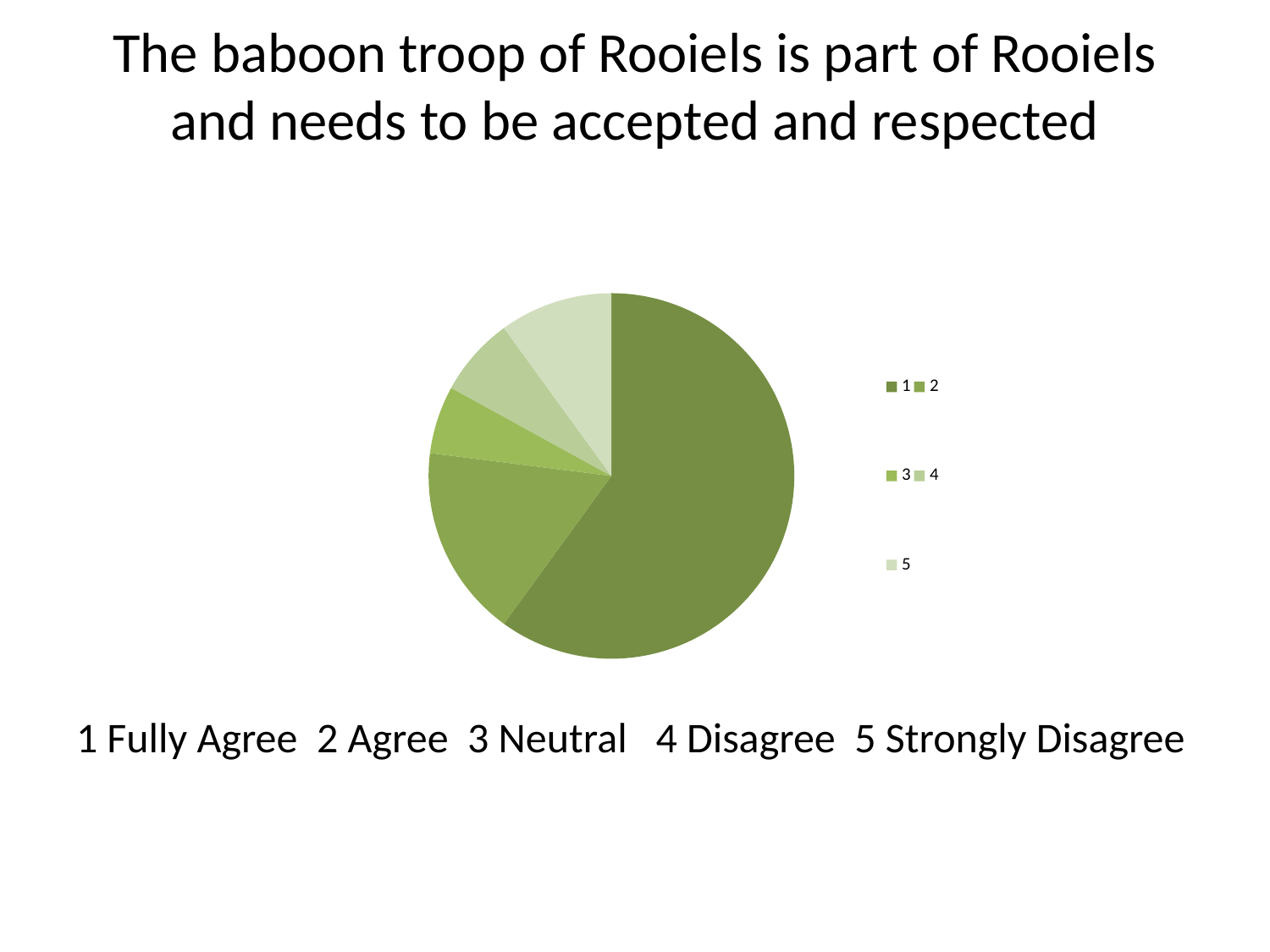
Which response option, by its label in the key below the chart, has the largest share of the pie? Fully Agree What kind of chart is shown on the slide? pie chart Which category has the largest slice in the pie chart? 1 How many slices does the pie chart have? 5 Which slice is larger in the pie chart, category 2 or category 3? 2 Which slice is larger in the pie chart, category 2 or category 5? 2 What is the title of the slide containing the pie chart? The baboon troop of Rooiels is part of Rooiels and needs to be accepted and respected Which slice is larger in the pie chart, category 1 or category 5? 1 According to the key below the chart, what does category 5 stand for? Strongly Disagree How many entries does the legend of the pie chart list? 5 Does the slice for category 1 cover more or less than half of the pie? more than half